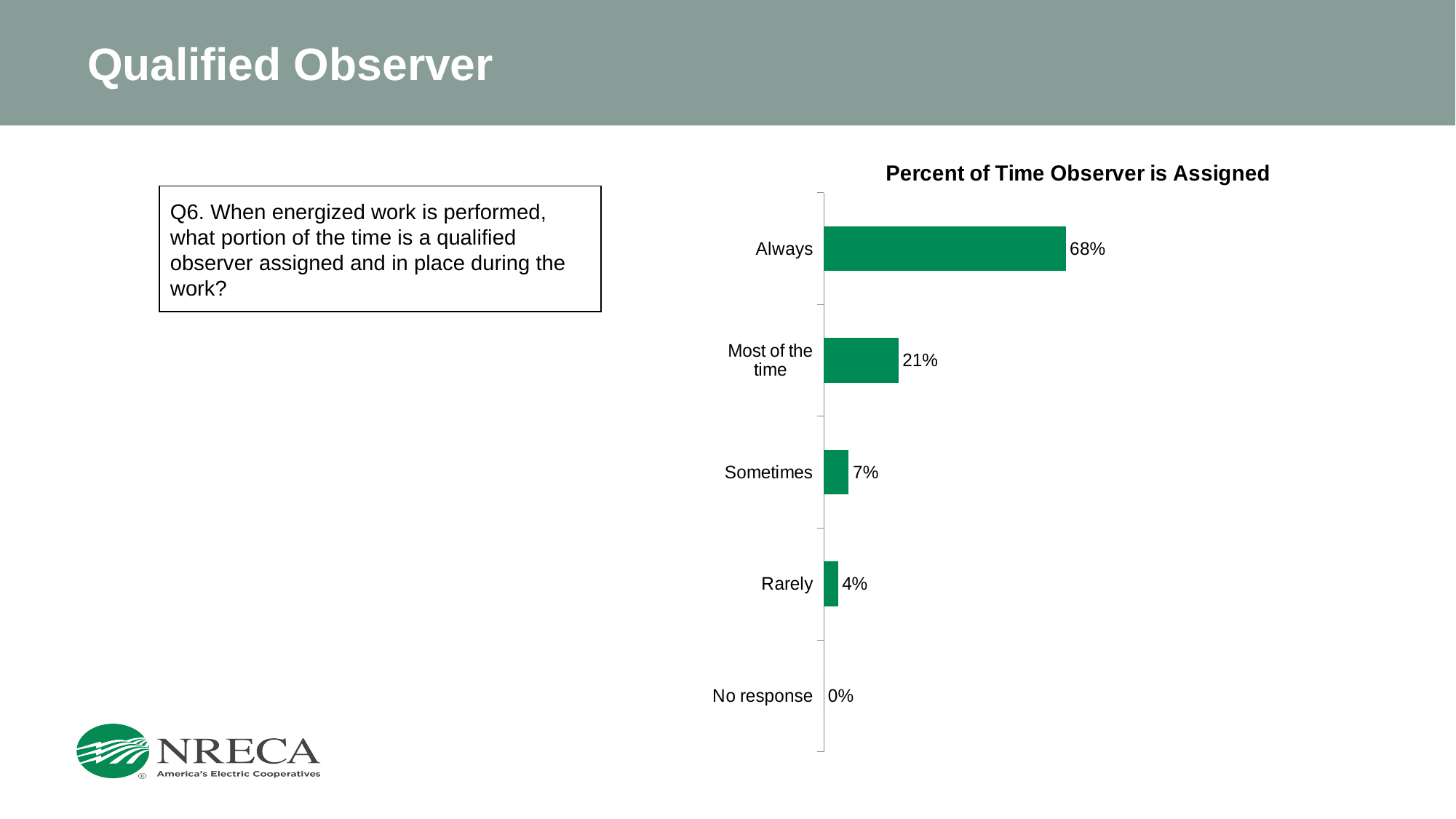
What is the difference between the values for Always and Most of the time? 47% What is the value for Most of the time? 21% What is the value for Sometimes? 7% What is the value for Always? 68% What is the value for No response? 0% Which category has the lowest value? No response Which category has the highest value? Always What is the title of the chart? Percent of Time Observer is Assigned What is the value for Rarely? 4% Which is larger, the value for Sometimes or the value for Rarely? Sometimes How many categories are shown in the chart? 5 What kind of chart is shown on the slide? Bar chart